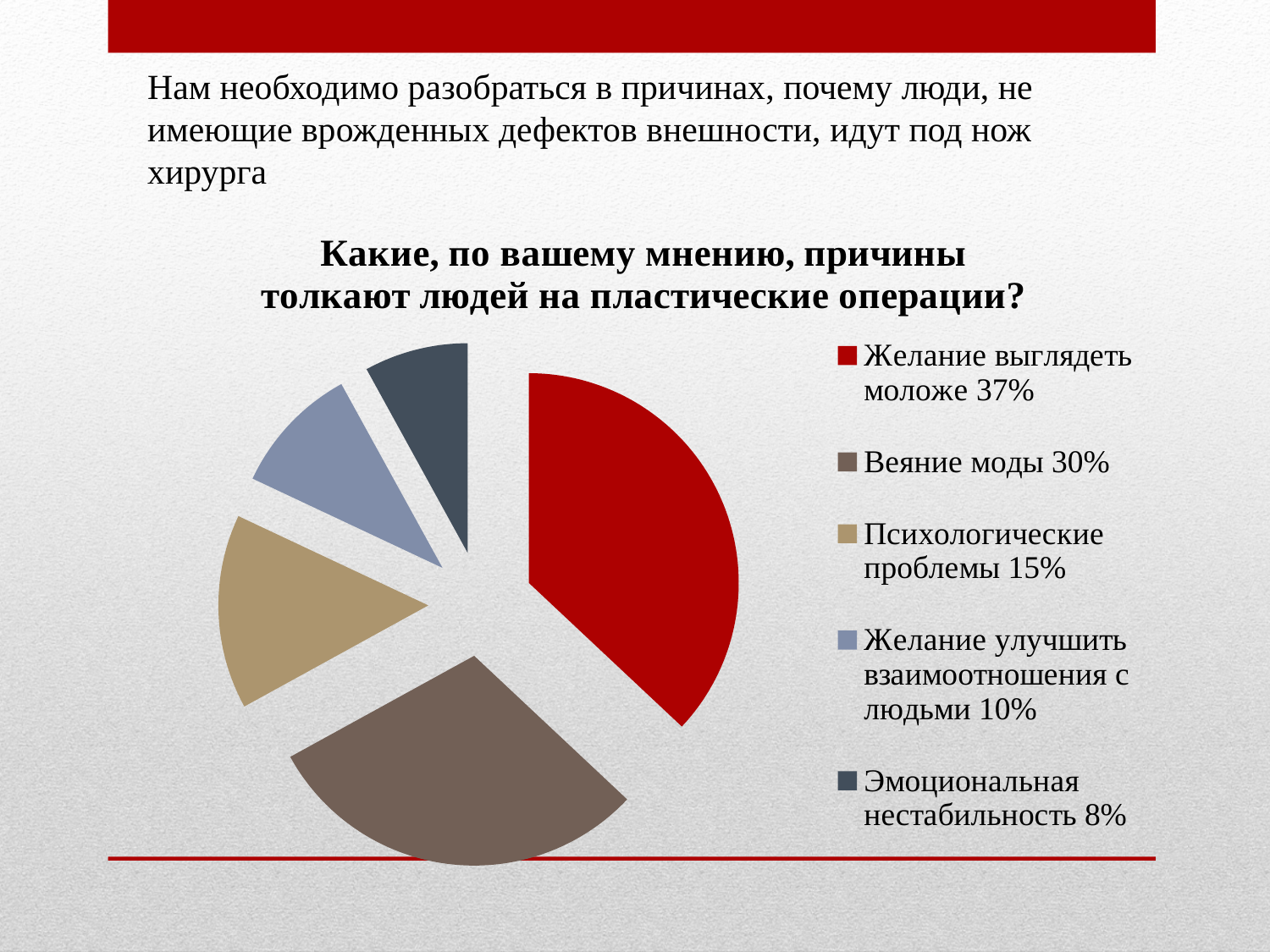
Which reason has the smallest share of the pie? Эмоциональная нестабильность What share of the pie is 'Веяние моды'? 30% What share of the pie is 'Психологические проблемы'? 15% What colour is the slice for 'Желание выглядеть моложе'? red What is the title of the chart? Какие, по вашему мнению, причины толкают людей на пластические операции? What kind of chart is shown on the slide? pie chart Which is larger: 'Желание улучшить взаимоотношения с людьми' or 'Психологические проблемы'? Психологические проблемы How many slices does the pie chart have? 5 What is the difference in percentage points between 'Желание выглядеть моложе' and 'Веяние моды'? 7 Which reason has the largest share of the pie? Желание выглядеть моложе What share of the pie is 'Эмоциональная нестабильность'? 8% What is the combined share of 'Желание улучшить взаимоотношения с людьми' and 'Эмоциональная нестабильность'? 18%